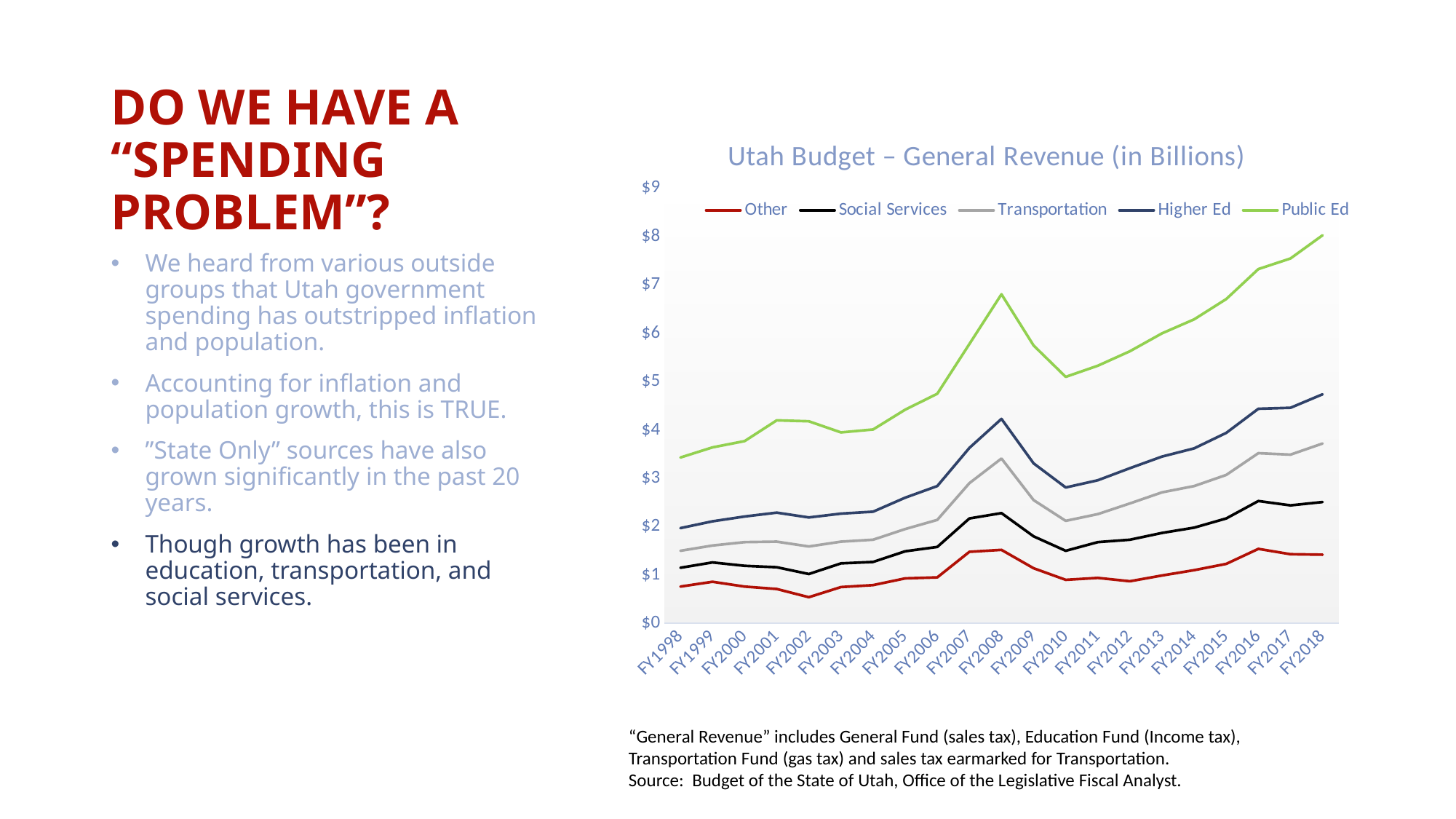
What is the title of the chart? Utah Budget – General Revenue (in Billions) Which series is plotted with a green line? Public Ed How many series does the legend of the chart list? 5 Which series has the highest value in FY2018? Public Ed How many fiscal years are plotted along the x axis of the chart? 21 What kind of chart is shown on the slide? line chart In which fiscal year does the Public Ed series reach its highest value? FY2018 Does the Public Ed series rise or fall from FY2010 to FY2018? rise Is the value for Other in FY2002 greater or less than $1? less